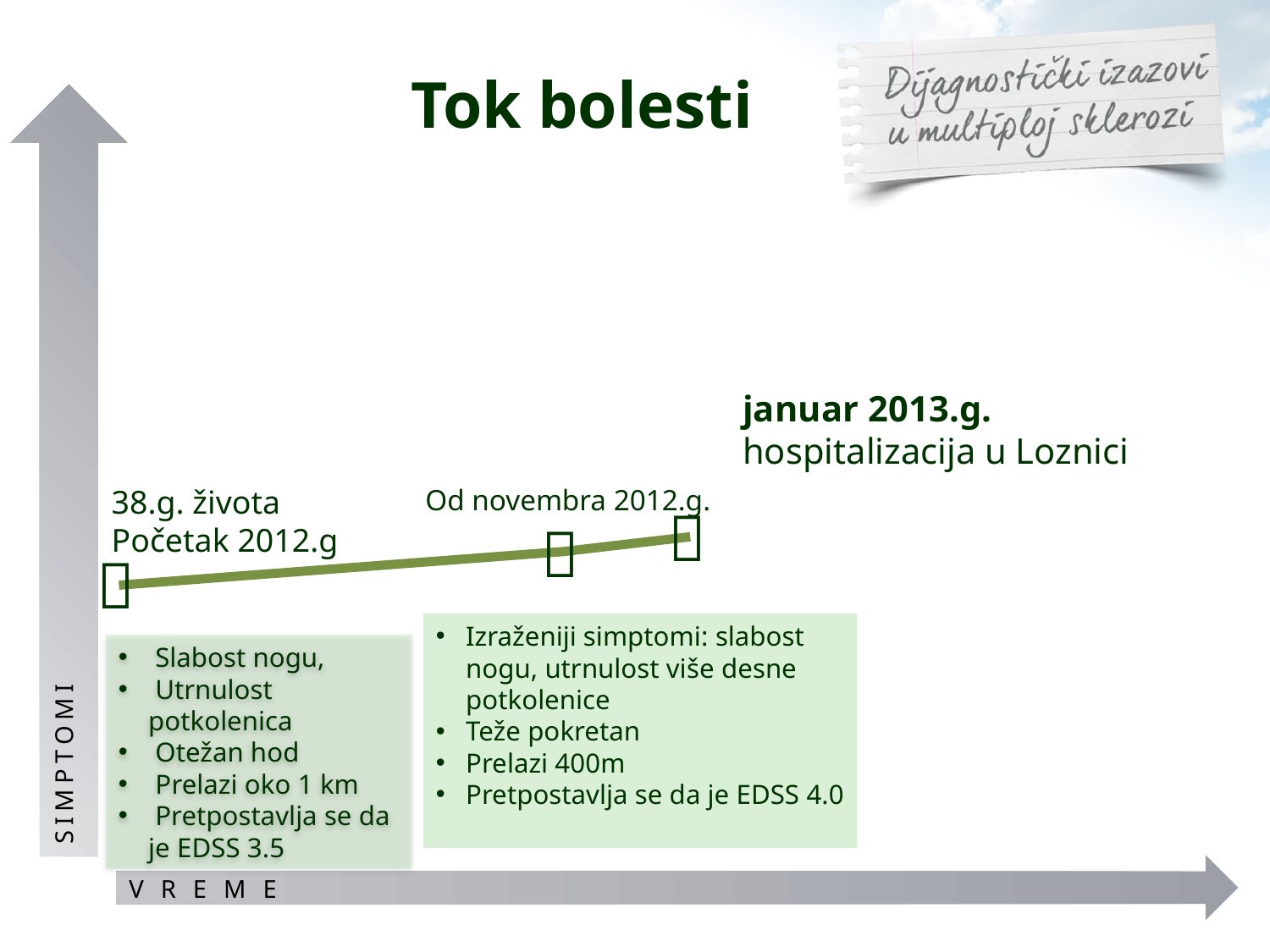
What does the horizontal axis of the diagram represent? VREME Does the line in the diagram rise or fall along the time axis? rise How many marked points are there on the line in the diagram? 3 What EDSS value is assumed at the first point (Početak 2012.g)? EDSS 3.5 What does the vertical axis of the diagram represent? SIMPTOMI What event is marked at the last point of the timeline, in January 2013? hospitalizacija u Loznici What EDSS value is assumed at the point from November 2012? EDSS 4.0 What is the difference between the assumed EDSS values at the November 2012 point and the start of 2012 point? 0.5 Which point has the higher assumed EDSS value, Početak 2012.g or Od novembra 2012.g.? Od novembra 2012.g.